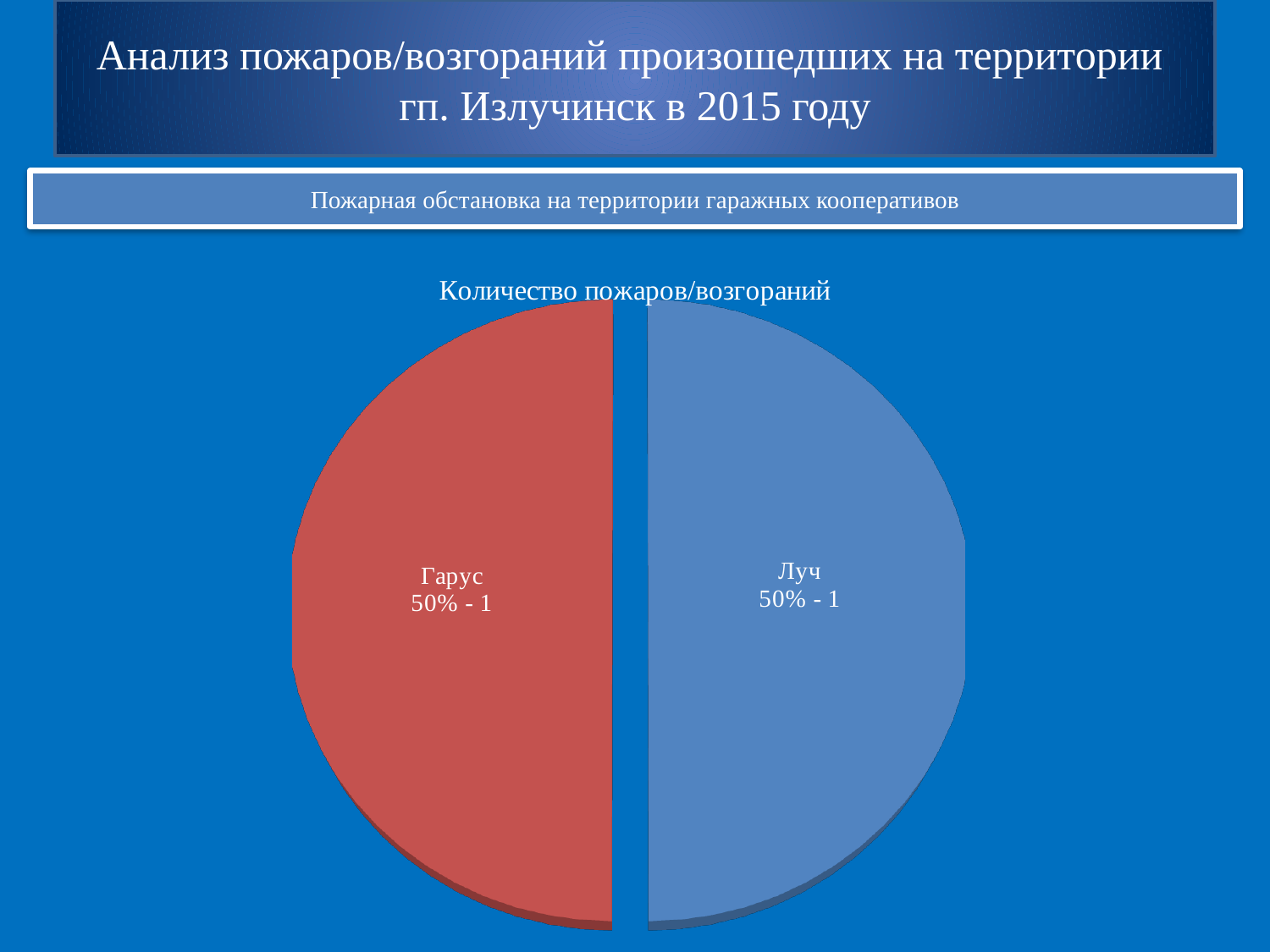
What is the title of the chart? Количество пожаров/возгораний What kind of chart is shown on the slide? pie chart What share of the pie does the Гарус slice represent? 50% What share of the pie does the Луч slice represent? 50% What is the difference between the number of fires for Гарус and for Луч? 0 What is the number of fires shown for Луч? 1 Which slice of the pie is coloured red? Гарус How many slices does the pie chart have? 2 What is the number of fires shown for Гарус? 1 What is the total number of fires across both slices of the pie? 2